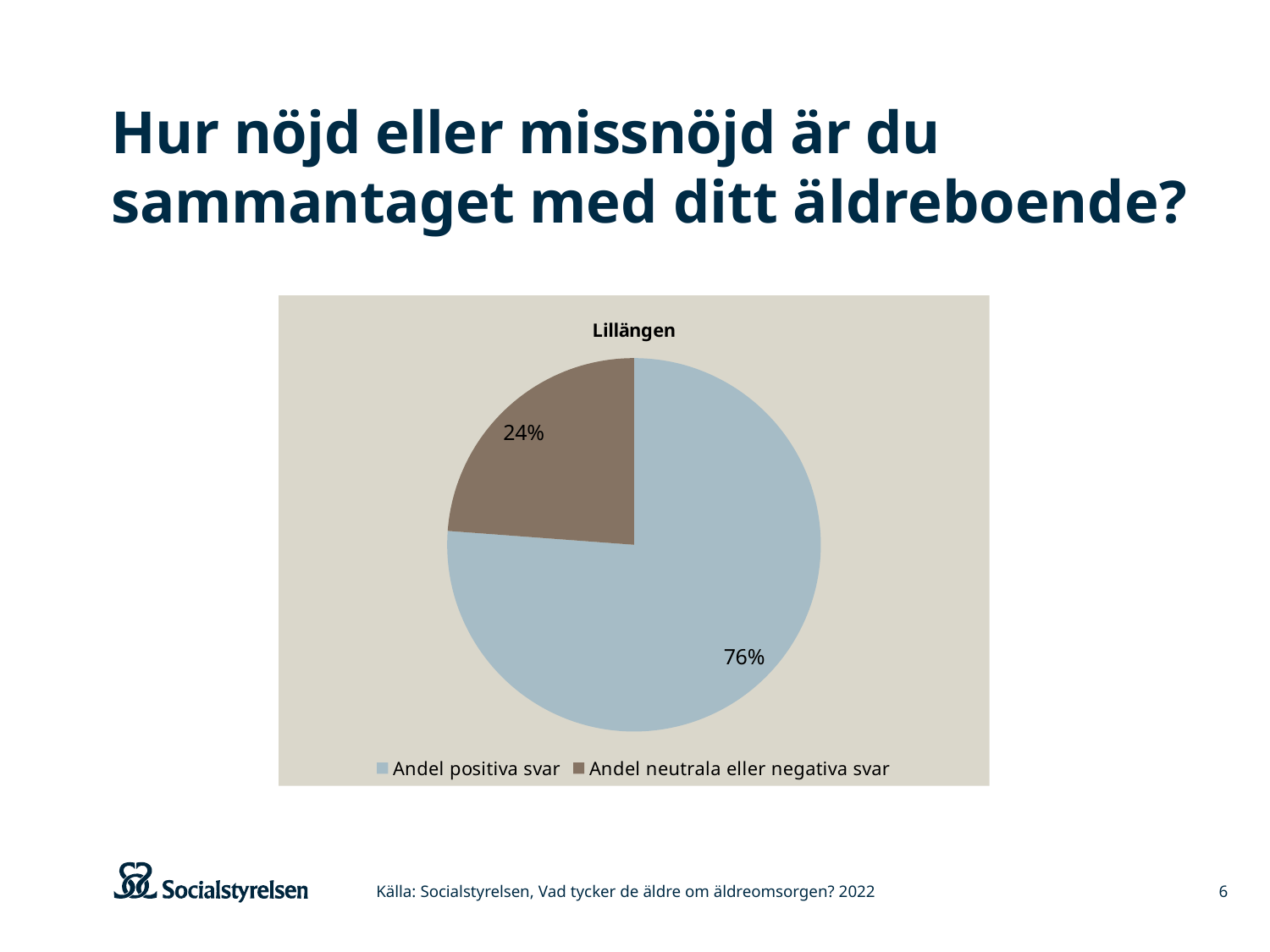
Which slice is the largest? Andel positiva svar Which slice is the smallest? Andel neutrala eller negativa svar Is the share for 'Andel positiva svar' greater or less than 50%? greater What share of the pie is 'Andel positiva svar'? 76% What is the difference in percentage points between 'Andel positiva svar' and 'Andel neutrala eller negativa svar'? 52 percentage points How many slices does the pie chart have? 2 Which is larger: 'Andel positiva svar' or 'Andel neutrala eller negativa svar'? Andel positiva svar What colour is the slice for 'Andel neutrala eller negativa svar'? brown What is the title of the chart? Lillängen How many entries does the legend list? 2 What share of the pie is 'Andel neutrala eller negativa svar'? 24% What kind of chart is shown on the slide? pie chart